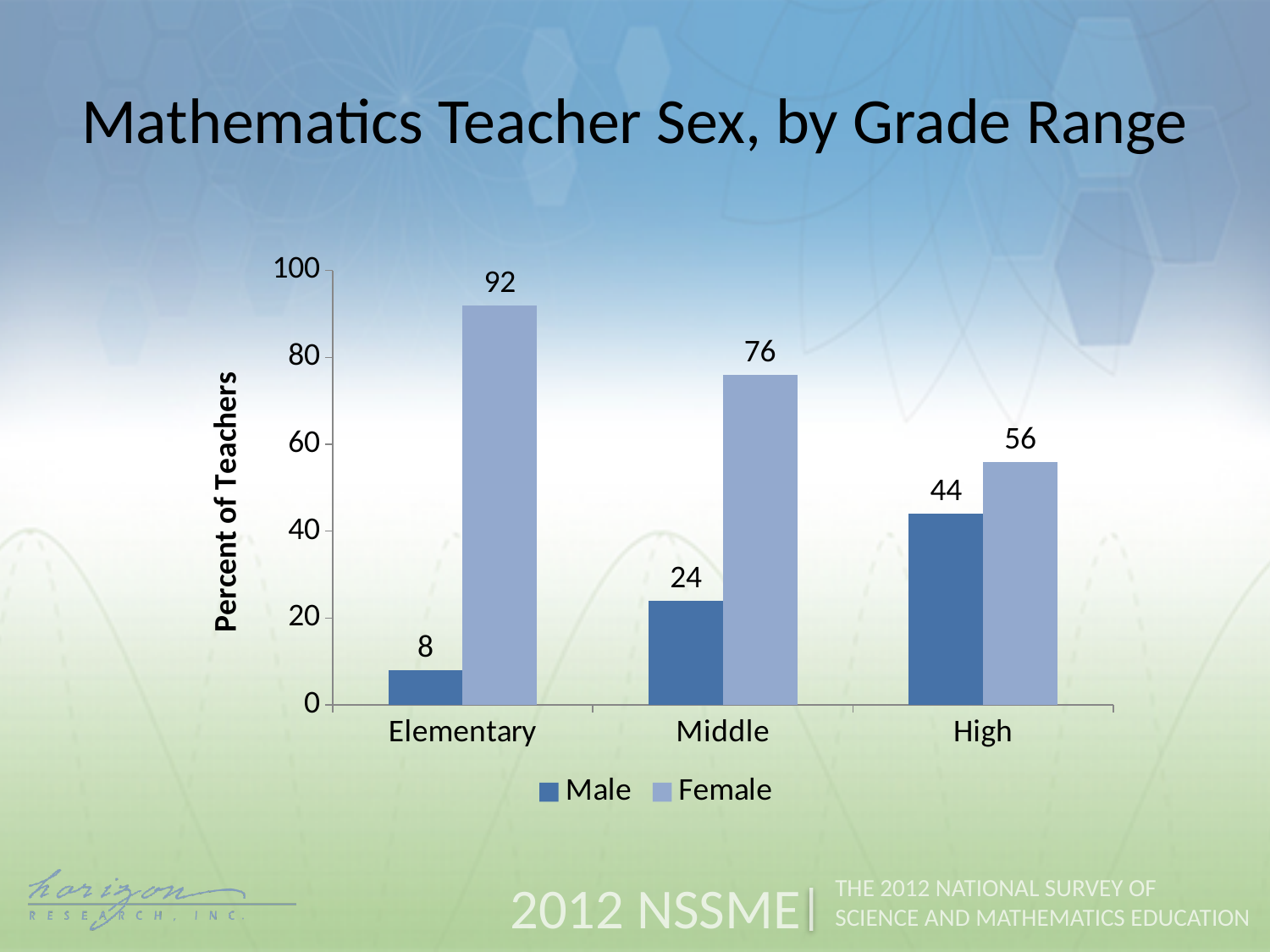
Which grade range has the lowest value for Female teachers? High What is the value for Male teachers in the Middle grade range? 24 Do the Female values rise or fall from Elementary to High? fall What kind of chart is shown on the slide? bar chart What is the value for Male teachers in the High grade range? 44 How many grade range categories are shown on the x axis? 3 What is the difference between the Female and Male values in the Elementary grade range? 84 Which grade range has the highest value for Male teachers? High What is the value for Female teachers in the Elementary grade range? 92 Is the value for Female teachers in the Middle grade range greater or less than 60? greater How many series does the legend list? 2 Which is larger in the High grade range, the Male value or the Female value? Female